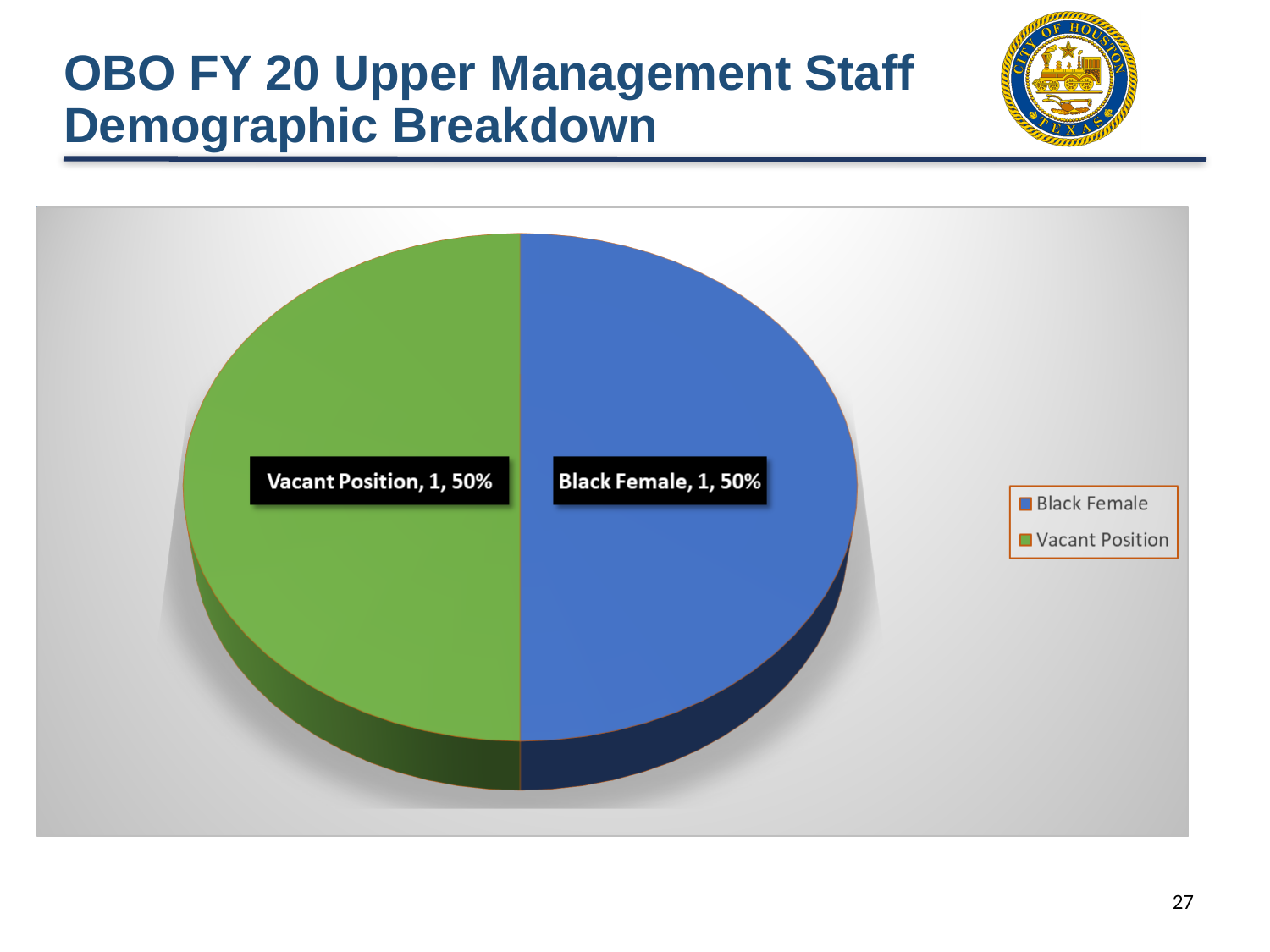
What is the title of the slide containing the pie chart? OBO FY 20 Upper Management Staff Demographic Breakdown Which colour represents Vacant Position in the pie chart? green How many slices does the pie chart have? 2 What share of the pie does Black Female represent? 50% What is the difference between the counts for Black Female and Vacant Position? 0 How many entries does the legend list? 2 What is the count shown for Vacant Position? 1 What is the count shown for Black Female? 1 What share of the pie does Vacant Position represent? 50% What is the total of the counts shown for the two slices? 2 What kind of chart is shown on the slide? pie chart